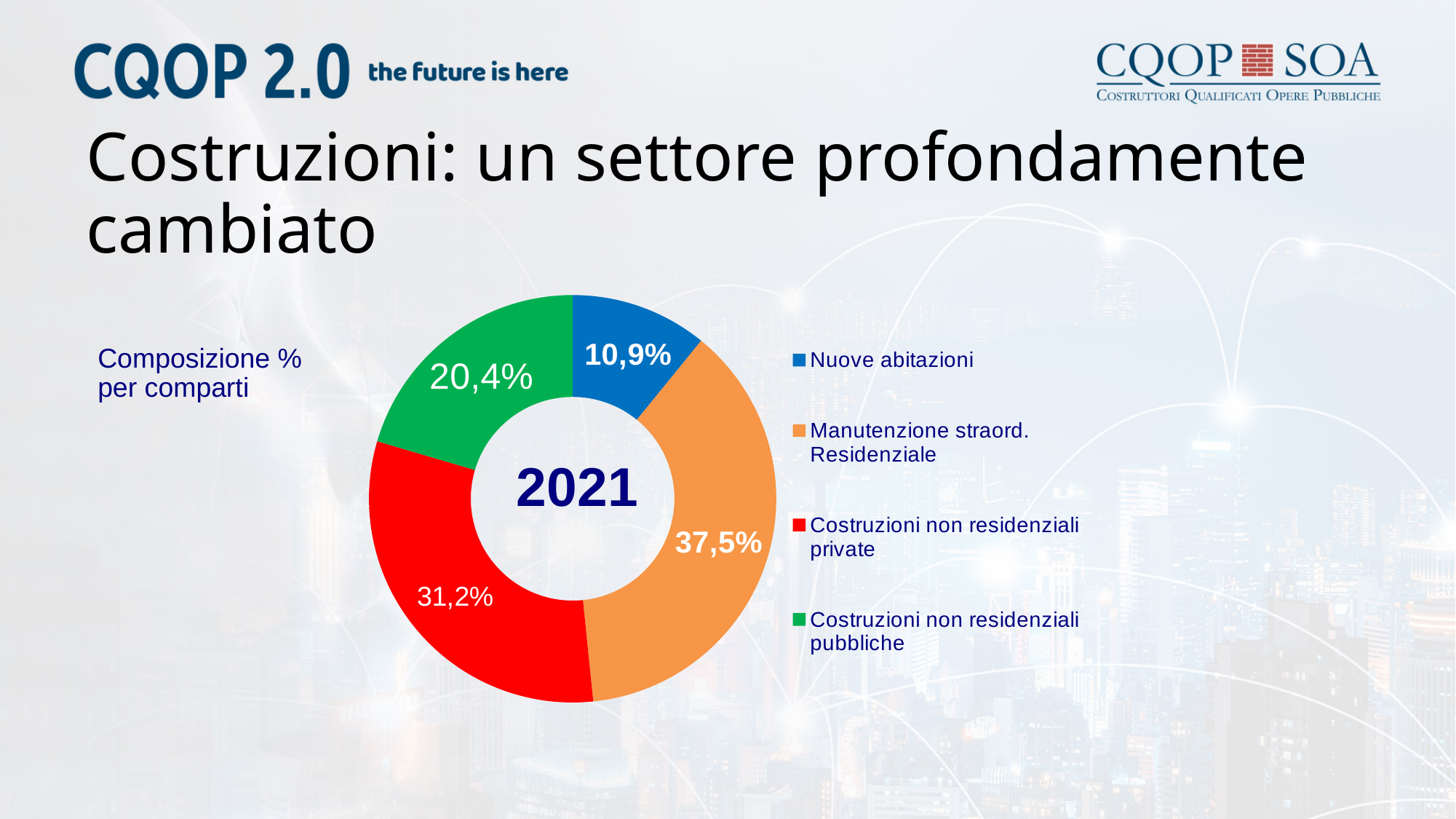
What year is shown in the centre of the chart? 2021 What is the difference between the shares of Manutenzione straord. Residenziale and Costruzioni non residenziali private? 6,3% What is the value shown for Costruzioni non residenziali pubbliche? 20,4% Which category has the smallest share of the pie? Nuove abitazioni What is the value shown for Costruzioni non residenziali private? 31,2% Which category has the largest share of the pie? Manutenzione straord. Residenziale What kind of chart is shown on the slide? Pie chart (doughnut) What share of the pie does Nuove abitazioni represent? 10,9% What is the value shown for Manutenzione straord. Residenziale? 37,5% Which is larger: the share for Costruzioni non residenziali pubbliche or the share for Nuove abitazioni? Costruzioni non residenziali pubbliche How many categories are shown in the pie chart? 4 Which colour represents Costruzioni non residenziali private in the chart? Red